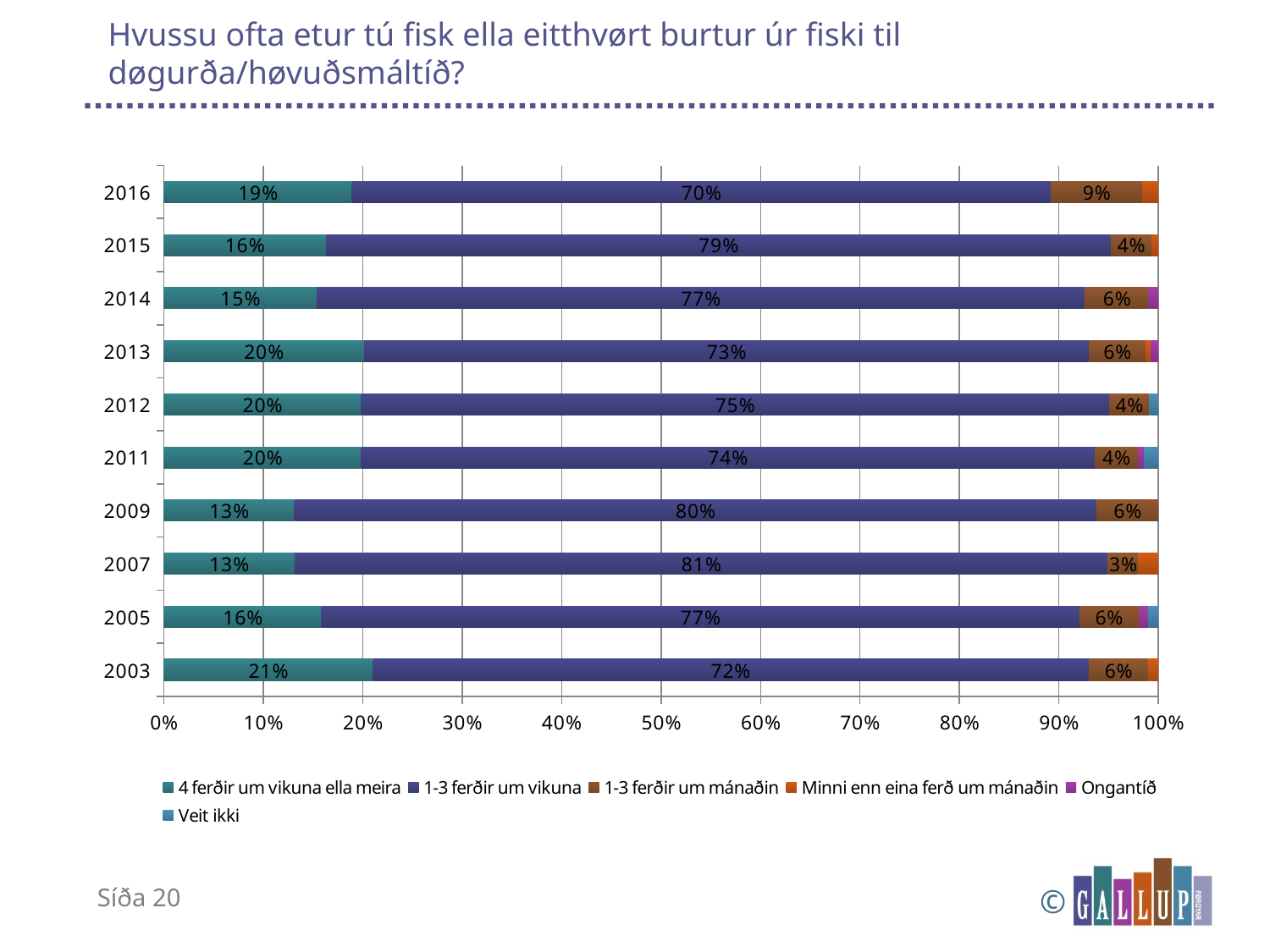
What is the value for '4 ferðir um vikuna ella meira' in 2016? 19% What is the difference between the '1-3 ferðir um vikuna' values for 2015 and 2016? 9 percentage points What is the value for '1-3 ferðir um vikuna' in 2007? 81% Which year has the highest value for '1-3 ferðir um mánaðin'? 2016 Which year has the highest value for '1-3 ferðir um vikuna'? 2007 Which year has the highest value for '4 ferðir um vikuna ella meira'? 2003 What is the value for '1-3 ferðir um mánaðin' in 2016? 9% How many series does the legend list? 6 What is the first entry in the chart's legend? 4 ferðir um vikuna ella meira How many years (categories) are shown on the chart? 10 What kind of chart is shown on the slide? Stacked bar chart Which year has the larger value for '4 ferðir um vikuna ella meira', 2013 or 2014? 2013